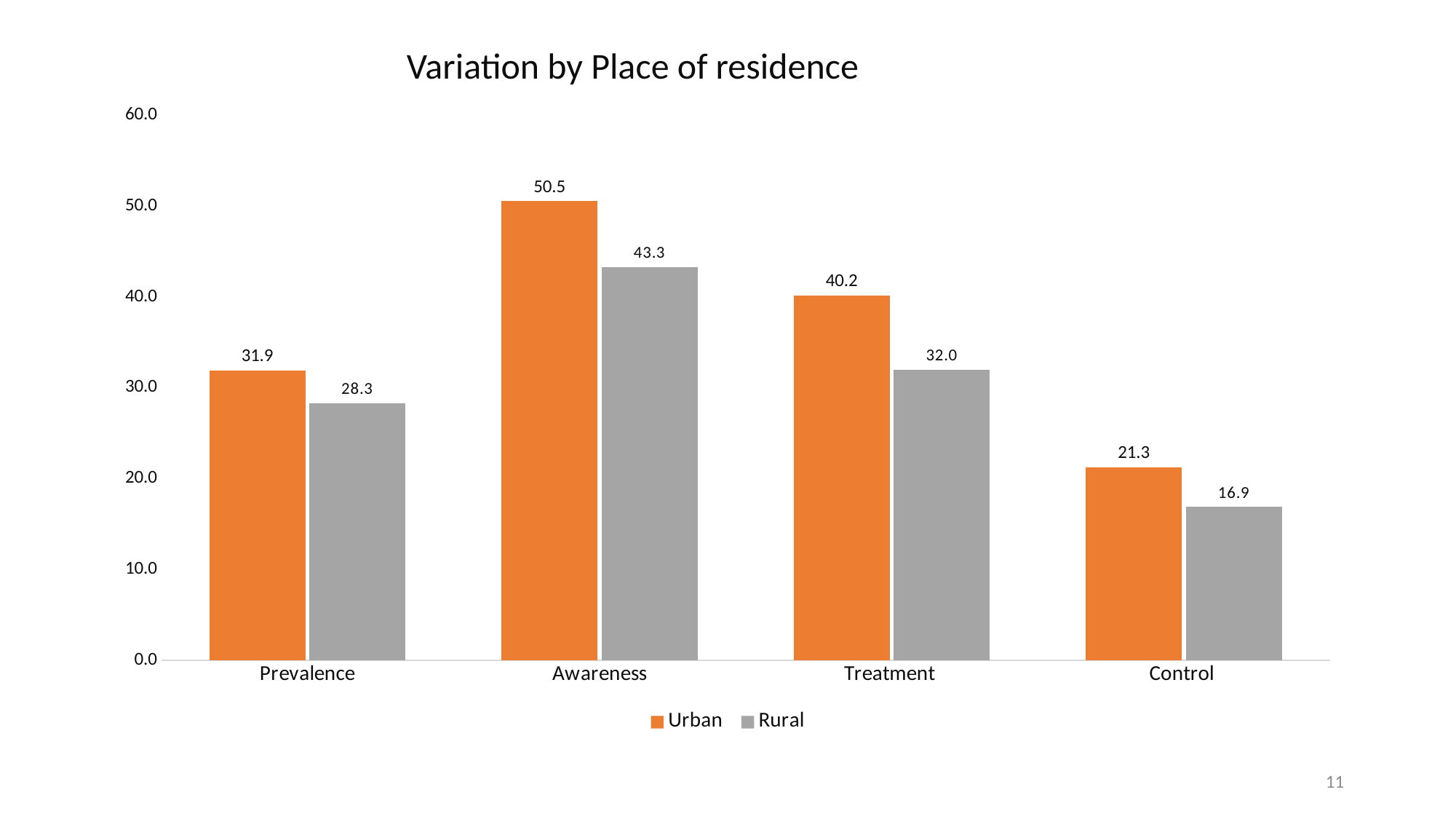
What kind of chart is shown on the slide? Bar chart Which is larger for Awareness, the Urban value or the Rural value? Urban What is the difference between the Urban and Rural values for Prevalence? 3.6 How many series does the legend list? 2 What is the Rural value for Treatment? 32.0 How many categories are shown on the x axis? 4 What is the Urban value for Awareness? 50.5 What is the difference between the Urban and Rural values for Treatment? 8.2 Which category has the highest Urban value? Awareness Is the Urban value for Control greater or less than 20.0? greater Which category has the lowest Rural value? Control What is the Rural value for Control? 16.9